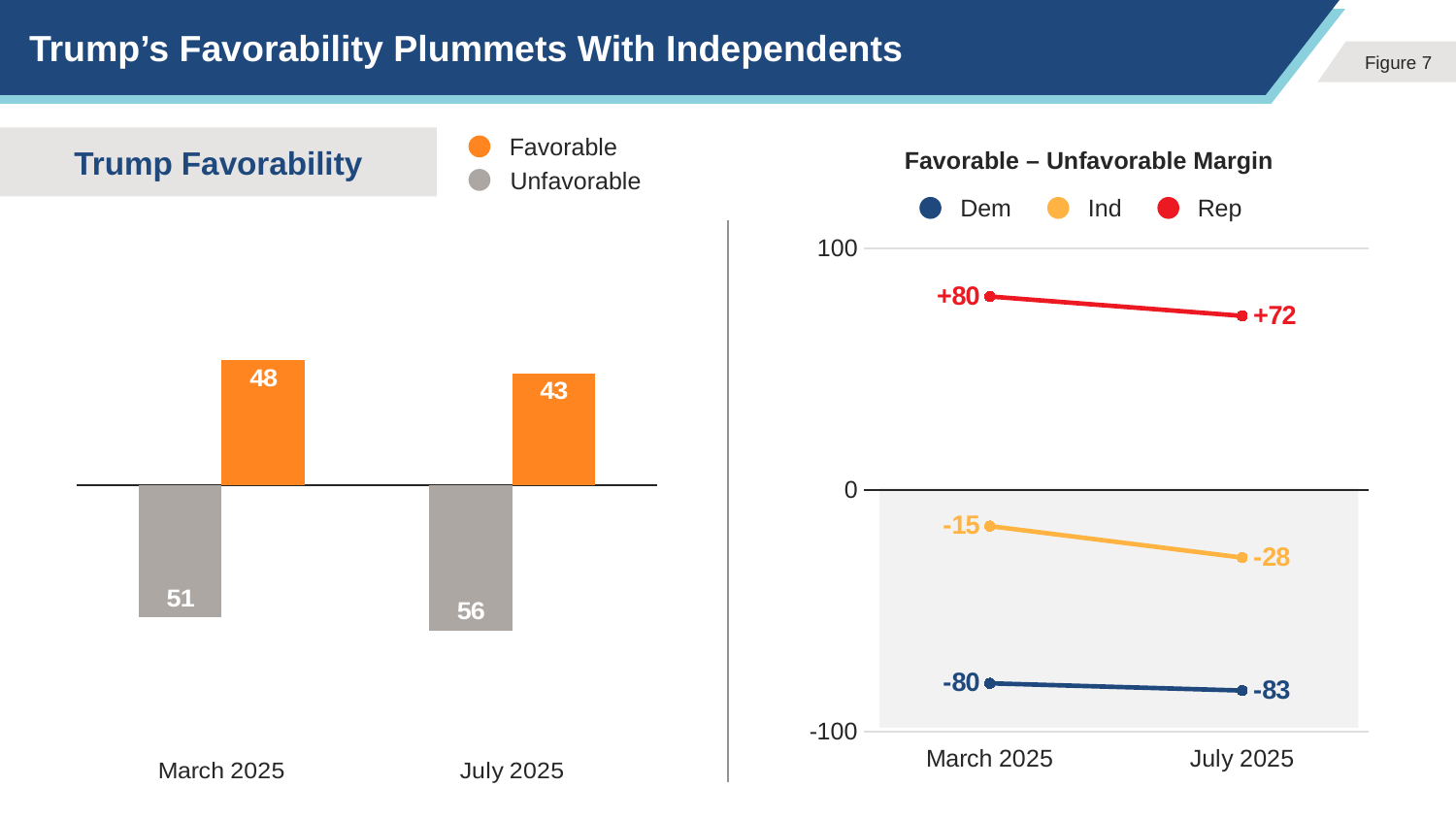
In the Favorable – Unfavorable Margin chart, how many series does the legend list? 3 In the Trump Favorability chart, which is larger in July 2025, Favorable or Unfavorable? Unfavorable In the Trump Favorability chart, how many series does the legend list? 2 In the Favorable – Unfavorable Margin chart, does the Rep margin rise or fall from March 2025 to July 2025? Fall What kind of chart is the Trump Favorability chart? Bar chart In the Trump Favorability chart, what is the Favorable value for March 2025? 48 In the Favorable – Unfavorable Margin chart, what is the Rep value for March 2025? +80 In the Trump Favorability chart, what is the Unfavorable value for July 2025? 56 In the Favorable – Unfavorable Margin chart, which group has the lowest margin in July 2025? Dem In the Trump Favorability chart, by how much did the Favorable value fall from March 2025 to July 2025? 5 In the Favorable – Unfavorable Margin chart, by how much did the Ind margin change from March 2025 to July 2025? 13 In the Favorable – Unfavorable Margin chart, what is the Ind value for July 2025? -28